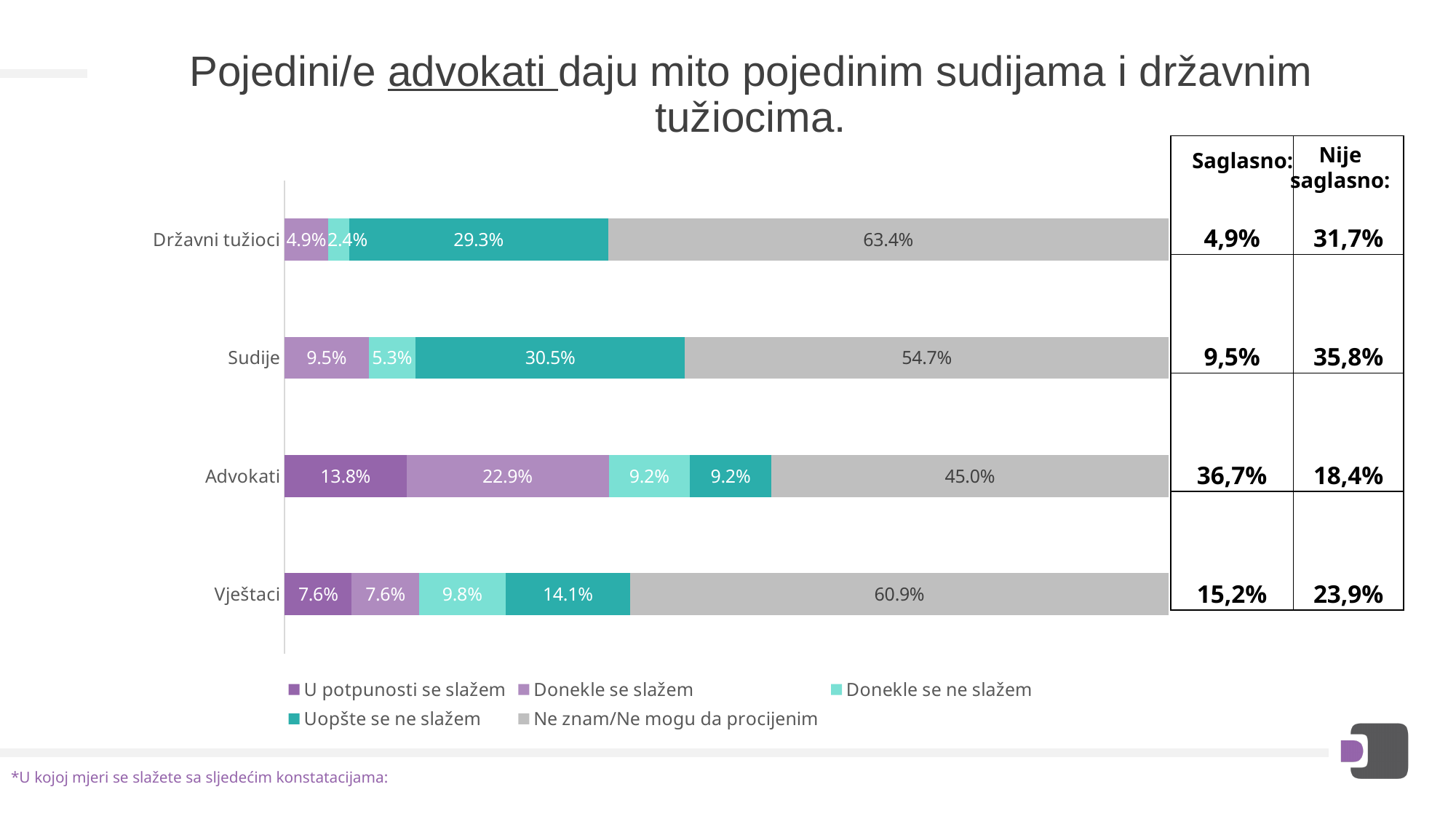
Which legend entry is shown in the darkest purple colour? U potpunosti se slažem What is the value of 'U potpunosti se slažem' for Advokati? 13.8% Which category has the lowest value for 'Ne znam/Ne mogu da procijenim'? Advokati Which is larger: the 'Uopšte se ne slažem' value for Državni tužioci or for Vještaci? Državni tužioci What type of chart is shown on the slide? stacked bar chart What is the value of 'Donekle se ne slažem' for Vještaci? 9.8% What is the value of 'Ne znam/Ne mogu da procijenim' for Državni tužioci? 63.4% How many categories (respondent groups) are shown on the chart? 4 How many series does the legend list? 5 What is the difference between the 'Donekle se slažem' values for Advokati and Sudije? 13.4% Which category has the highest value for 'Ne znam/Ne mogu da procijenim'? Državni tužioci What is the value of 'Uopšte se ne slažem' for Sudije? 30.5%